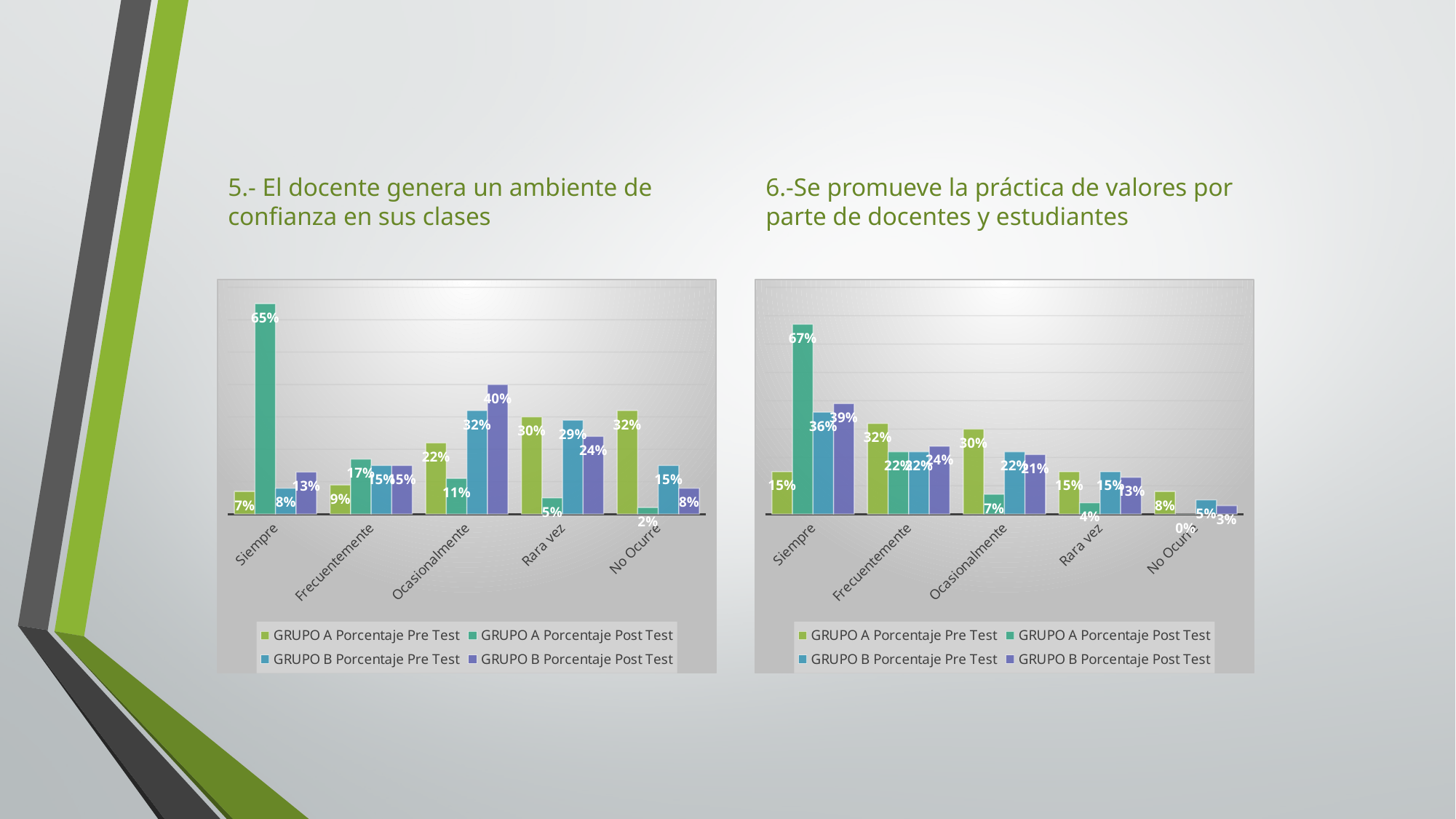
In the right chart (6.-Se promueve la práctica de valores por parte de docentes y estudiantes), which is larger for Frecuentemente: GRUPO A Porcentaje Pre Test or GRUPO A Porcentaje Post Test? GRUPO A Porcentaje Pre Test In the left chart (5.- El docente genera un ambiente de confianza en sus clases), which category has the highest GRUPO A Porcentaje Pre Test value? No Ocurre In the left chart (5.- El docente genera un ambiente de confianza en sus clases), what is the GRUPO B Porcentaje Post Test value for Ocasionalmente? 40% In the right chart (6.-Se promueve la práctica de valores por parte de docentes y estudiantes), what is the GRUPO A Porcentaje Post Test value for No Ocurre? 0% How many series does the legend of the right chart (6.-Se promueve la práctica de valores por parte de docentes y estudiantes) list? 4 In the left chart (5.- El docente genera un ambiente de confianza en sus clases), what is the GRUPO A Porcentaje Post Test value for Siempre? 65% What type of chart is the left chart (5.- El docente genera un ambiente de confianza en sus clases)? Bar chart In the right chart (6.-Se promueve la práctica de valores por parte de docentes y estudiantes), what is the GRUPO A Porcentaje Post Test value for Siempre? 67% In the left chart (5.- El docente genera un ambiente de confianza en sus clases), which category has the lowest GRUPO A Porcentaje Post Test value? No Ocurre In the left chart (5.- El docente genera un ambiente de confianza en sus clases), what is the difference between the GRUPO A Porcentaje Post Test and GRUPO A Porcentaje Pre Test values for Siempre? 58% In the right chart (6.-Se promueve la práctica de valores por parte de docentes y estudiantes), what is the GRUPO B Porcentaje Pre Test value for Siempre? 36% In the left chart (5.- El docente genera un ambiente de confianza en sus clases), how many categories are shown on the x axis? 5